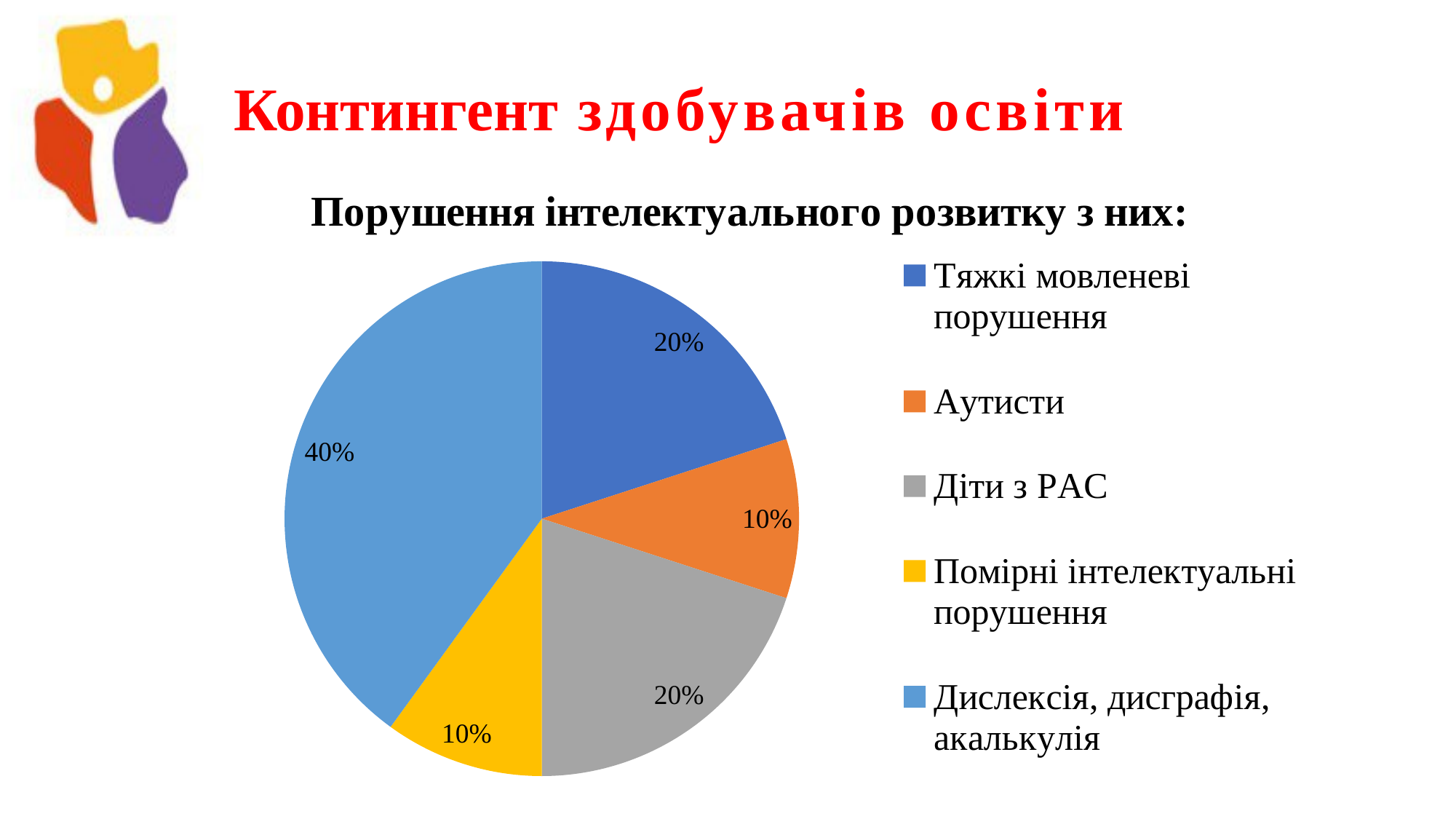
Which slice is larger: "Діти з РАС" or "Помірні інтелектуальні порушення"? Діти з РАС What share of the pie is labelled for "Аутисти"? 10% What is the difference in percentage points between the "Дислексія, дисграфія, акалькулія" slice and the "Аутисти" slice? 30 What is the title of the pie chart? Порушення інтелектуального розвитку з них: What share of the pie is labelled for "Дислексія, дисграфія, акалькулія"? 40% What kind of chart is shown on the slide? pie chart How many slices does the pie chart have? 5 What share of the pie is labelled for "Тяжкі мовленеві порушення"? 20% What share of the pie is labelled for "Діти з РАС"? 20% Which category has the largest slice of the pie? Дислексія, дисграфія, акалькулія What share of the pie is labelled for "Помірні інтелектуальні порушення"? 10% How many entries does the legend list? 5